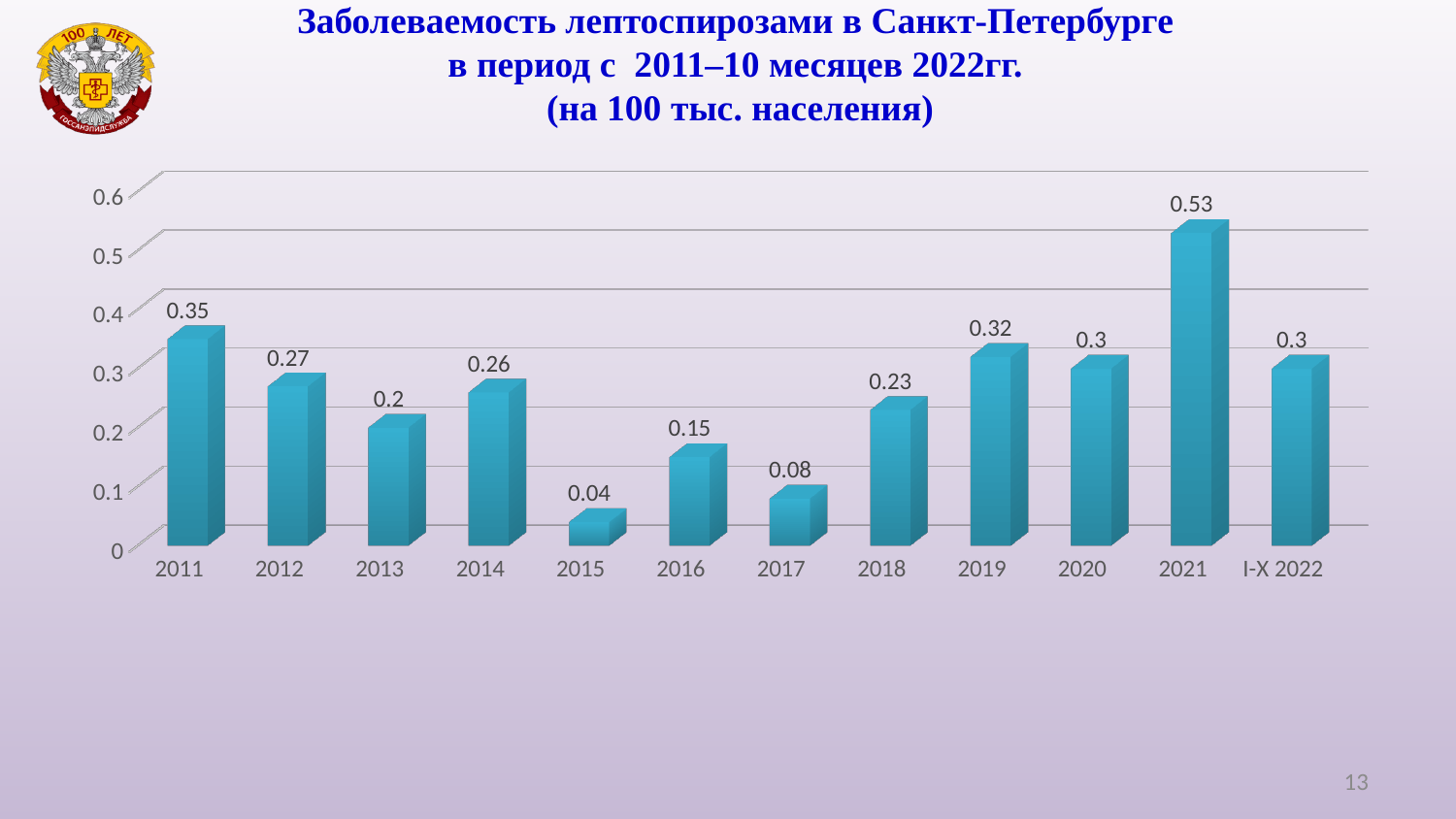
What is the difference between the values for 2011 and 2012? 0.08 What value is shown for I-X 2022? 0.3 Which year has the highest value on the chart? 2021 Which is larger, the value for 2018 or the value for 2019? 2019 Do the values rise or fall from 2015 to 2019? rise How many categories (periods) are shown on the x axis? 12 Is the value for 2021 greater or less than 0.5? greater What kind of chart is shown on the slide? bar chart What value is shown for 2015? 0.04 Which year has the lowest value on the chart? 2015 What is the difference between the values for 2021 and 2020? 0.23 What is the leptospirosis incidence value shown for 2011? 0.35